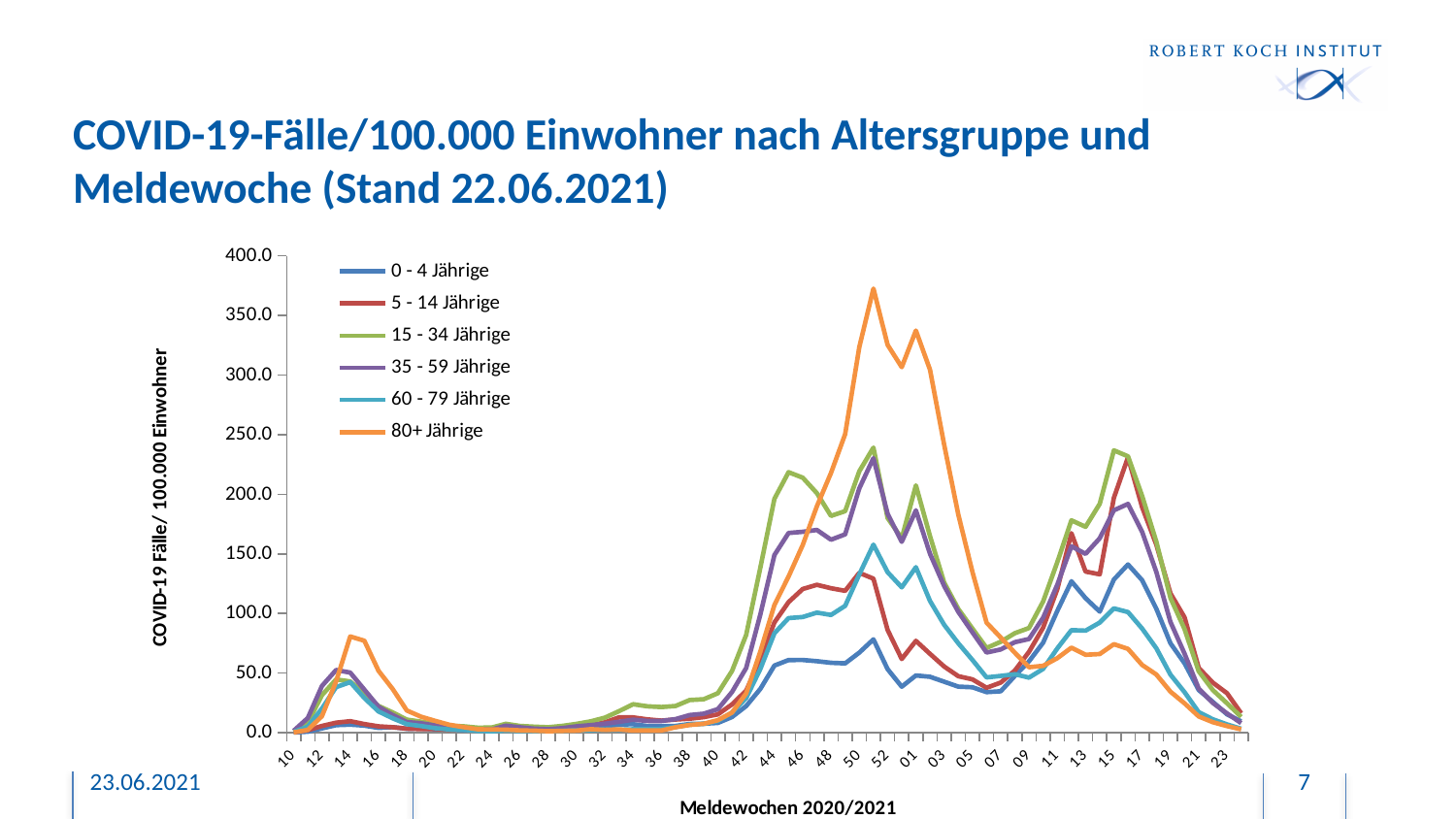
Around week 51, which is higher: 80+ Jährige or 0 - 4 Jährige? 80+ Jährige How many series does the legend list? 6 Is the value for 15 - 34 Jährige at its peak around week 51 greater or less than 200? greater Is the value for 80+ Jährige at week 14 (2020) greater or less than 50? greater Is the peak value for 0 - 4 Jährige greater or less than 200? less From week 17 to week 23 of 2021, do the values for all age groups rise or fall? fall What is the label of the y axis? COVID-19 Fälle/ 100.000 Einwohner Which age group reaches the highest peak in the chart? 80+ Jährige What kind of chart is shown on the slide? line chart What is the label of the x axis? Meldewochen 2020/2021